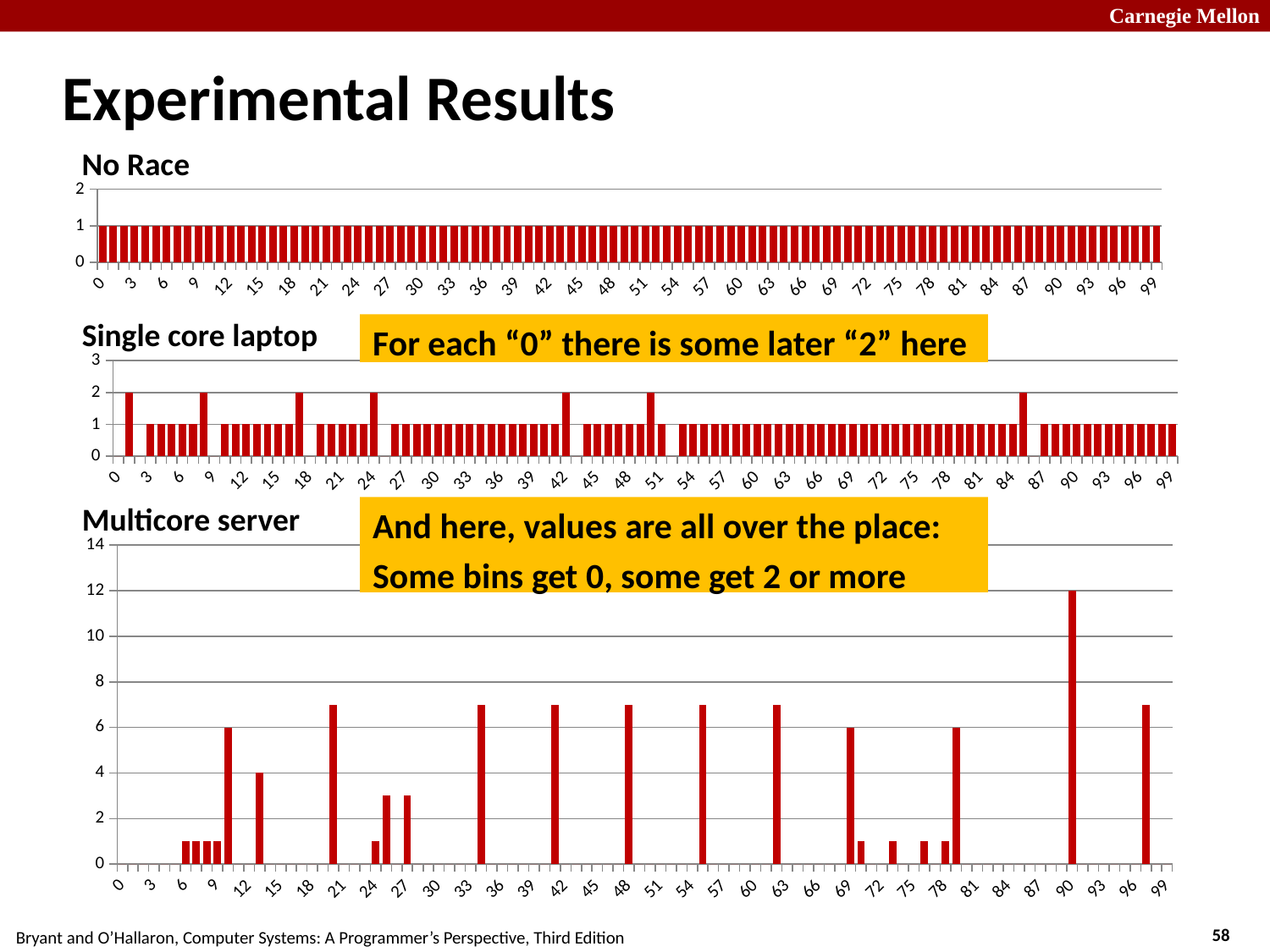
In the "Multicore server" chart, which bin has the highest value? 90 In the "Single core laptop" chart, is the tallest bar greater or less than 3? less In the "No Race" chart, what value does the bar at bin 0 reach? 1 In the "No Race" chart, what is the highest value shown on the y axis? 2 In the "Multicore server" chart, is the value at bin 90 greater or less than 10? greater In the "Multicore server" chart, which is larger: the value at bin 90 or the value at bin 10? bin 90 In the "Multicore server" chart, what value does the bar at bin 90 reach? 12 In the "Single core laptop" chart, what is the highest value reached by any bar? 2 In the "No Race" chart, do the values rise, fall, or stay flat across the bins? stay flat How many charts are shown on the slide? 3 In the "Multicore server" chart, what is the highest value shown on the y axis? 14 What kind of chart is the "No Race" chart at the top of the slide? bar chart